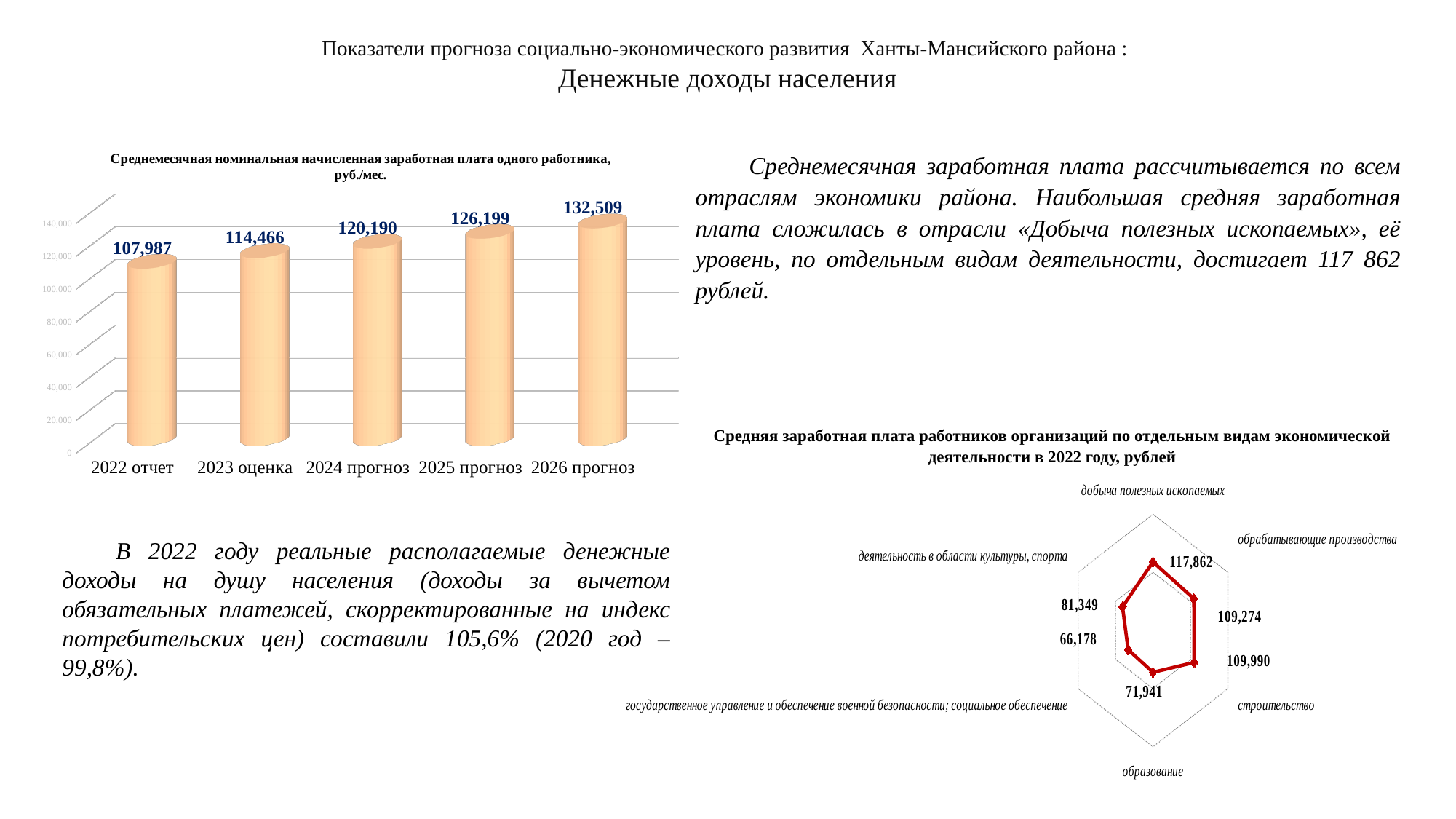
In the radar chart on the right, what is the difference between the values for добыча полезных ископаемых and государственное управление и обеспечение военной безопасности; социальное обеспечение? 51,684 In the bar chart on the left, which category has the highest value? 2026 прогноз In the radar chart on the right, which category has the lowest value? государственное управление и обеспечение военной безопасности; социальное обеспечение In the radar chart on the right, which is larger: the value for строительство or the value for образование? строительство In the bar chart on the left, what is the value for 2026 прогноз? 132,509 In the bar chart on the left, do the values rise or fall from 2022 to 2026? rise In the bar chart on the left, what is the difference between the values for 2026 прогноз and 2022 отчет? 24,522 In the bar chart on the left, which category has the lowest value? 2022 отчет In the radar chart on the right, what is the value for добыча полезных ископаемых? 117,862 In the bar chart on the left, how many categories are shown on the x axis? 5 What kind of chart is the chart on the left of the slide? bar chart In the bar chart on the left, what is the value for 2022 отчет? 107,987